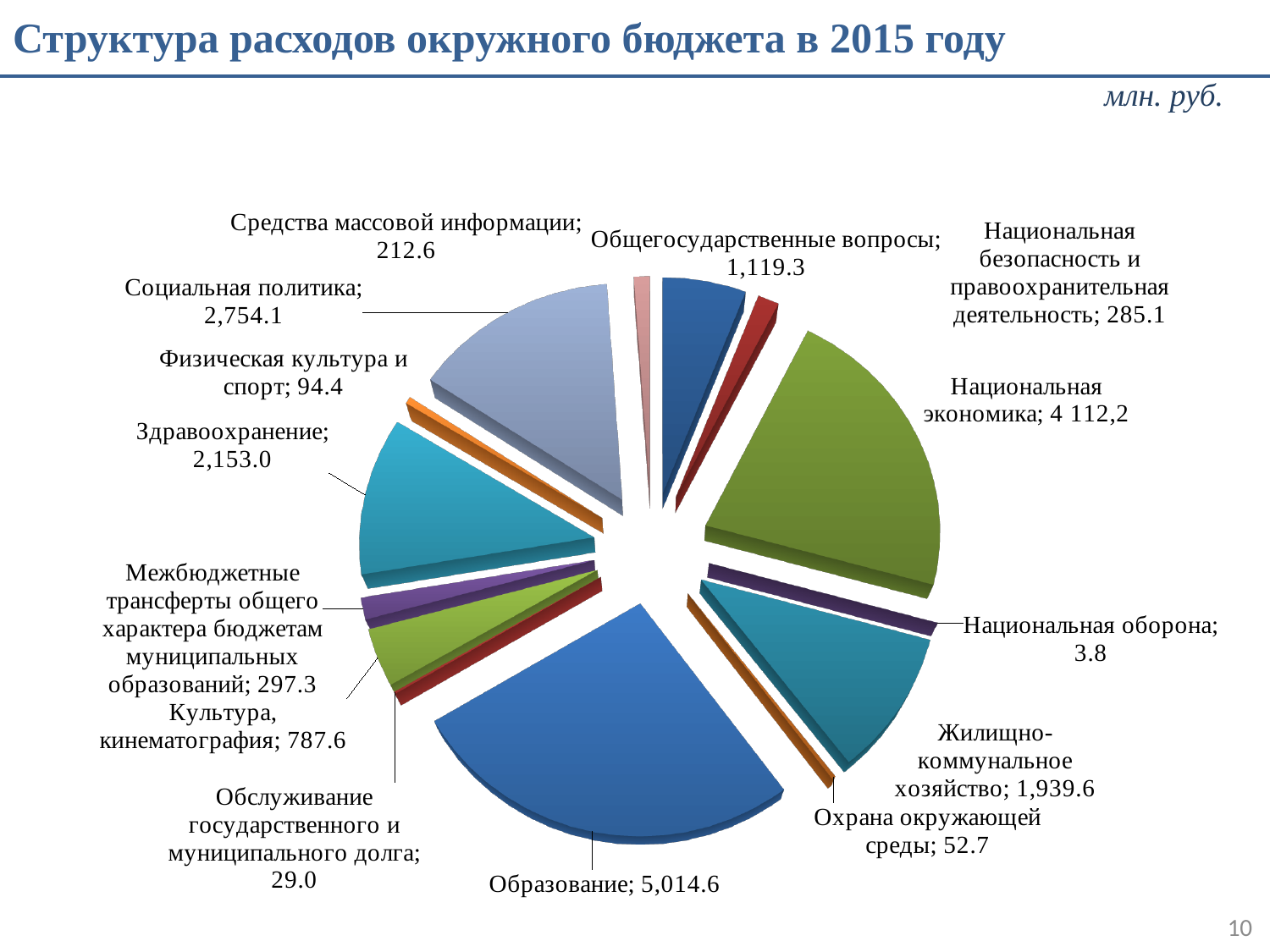
What is the value for Образование? 5,014.6 What is the difference between Образование and Национальная экономика? 902.4 What is the value for Национальная экономика? 4 112,2 Which is larger, Жилищно-коммунальное хозяйство or Общегосударственные вопросы? Жилищно-коммунальное хозяйство What is the value for Охрана окружающей среды? 52.7 In what units are the values on the chart given? млн. руб. What kind of chart is shown on the slide? Pie chart What is the value for Здравоохранение? 2,153.0 Which category has the largest share of the pie? Образование What is the difference between Социальная политика and Здравоохранение? 601.1 Which category has the smallest value? Национальная оборона How many categories does the pie chart show? 14